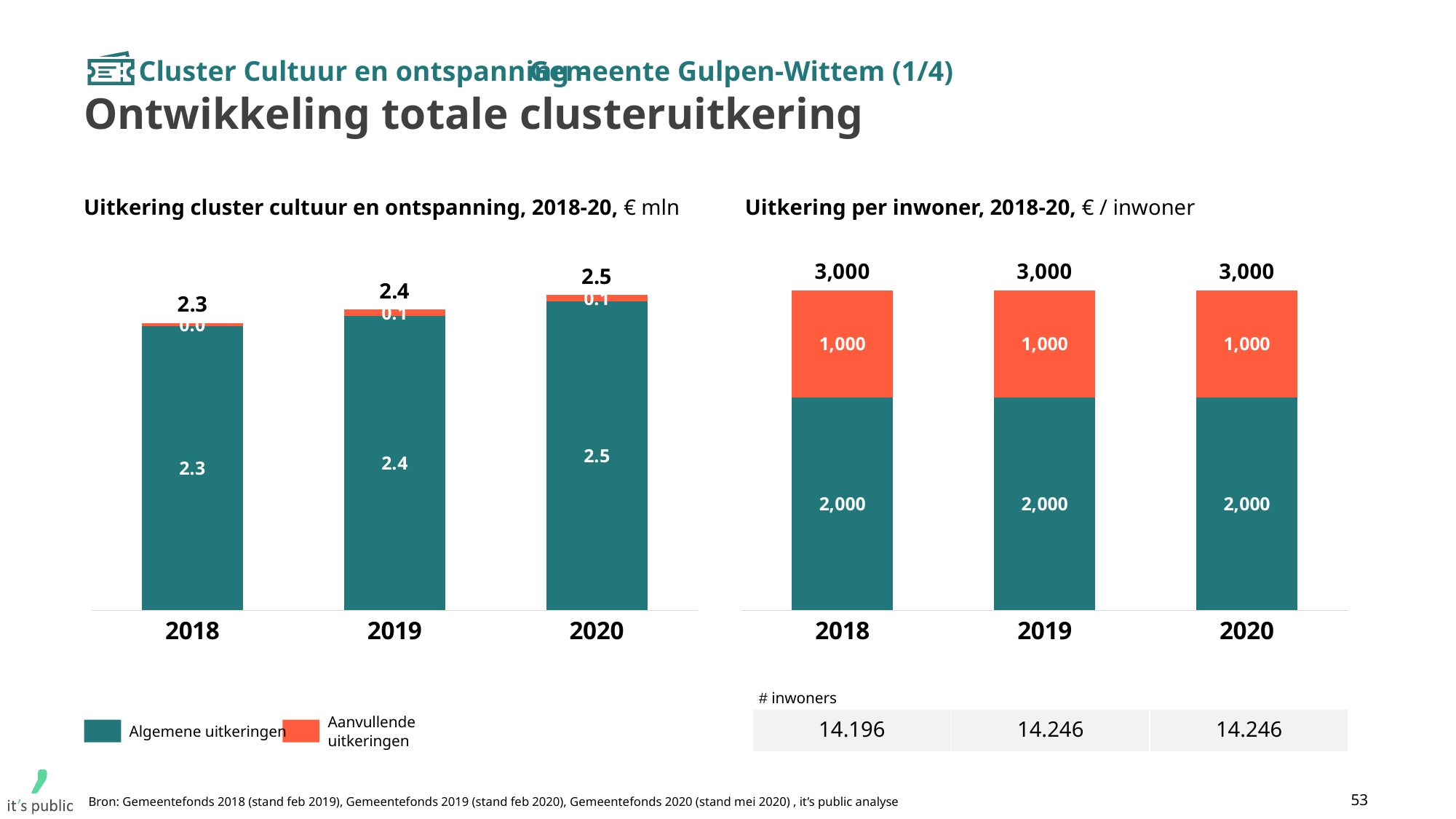
In the chart 'Uitkering cluster cultuur en ontspanning, 2018-20', which year has the lowest total? 2018 In the chart 'Uitkering cluster cultuur en ontspanning, 2018-20', what is the value of Algemene uitkeringen for 2018? 2.3 In the chart 'Uitkering cluster cultuur en ontspanning, 2018-20', what is the total value shown above the bar for 2020? 2.5 In the chart 'Uitkering per inwoner, 2018-20', what is the value of Algemene uitkeringen for 2019? 2,000 In the chart 'Uitkering cluster cultuur en ontspanning, 2018-20', do the totals rise or fall from 2018 to 2020? rise In the chart 'Uitkering cluster cultuur en ontspanning, 2018-20', what is the difference between the total for 2020 and the total for 2018? 0.2 How many series does the legend list for the charts on this slide? 2 What kind of chart is 'Uitkering cluster cultuur en ontspanning, 2018-20'? stacked bar chart In the chart 'Uitkering per inwoner, 2018-20', what is the value of Aanvullende uitkeringen for 2018? 1,000 In the chart 'Uitkering cluster cultuur en ontspanning, 2018-20', what is the value of Aanvullende uitkeringen for 2019? 0.1 In the chart 'Uitkering per inwoner, 2018-20', what is the total of the stacked bar for 2020? 3,000 In the chart 'Uitkering cluster cultuur en ontspanning, 2018-20', which year has the highest total? 2020